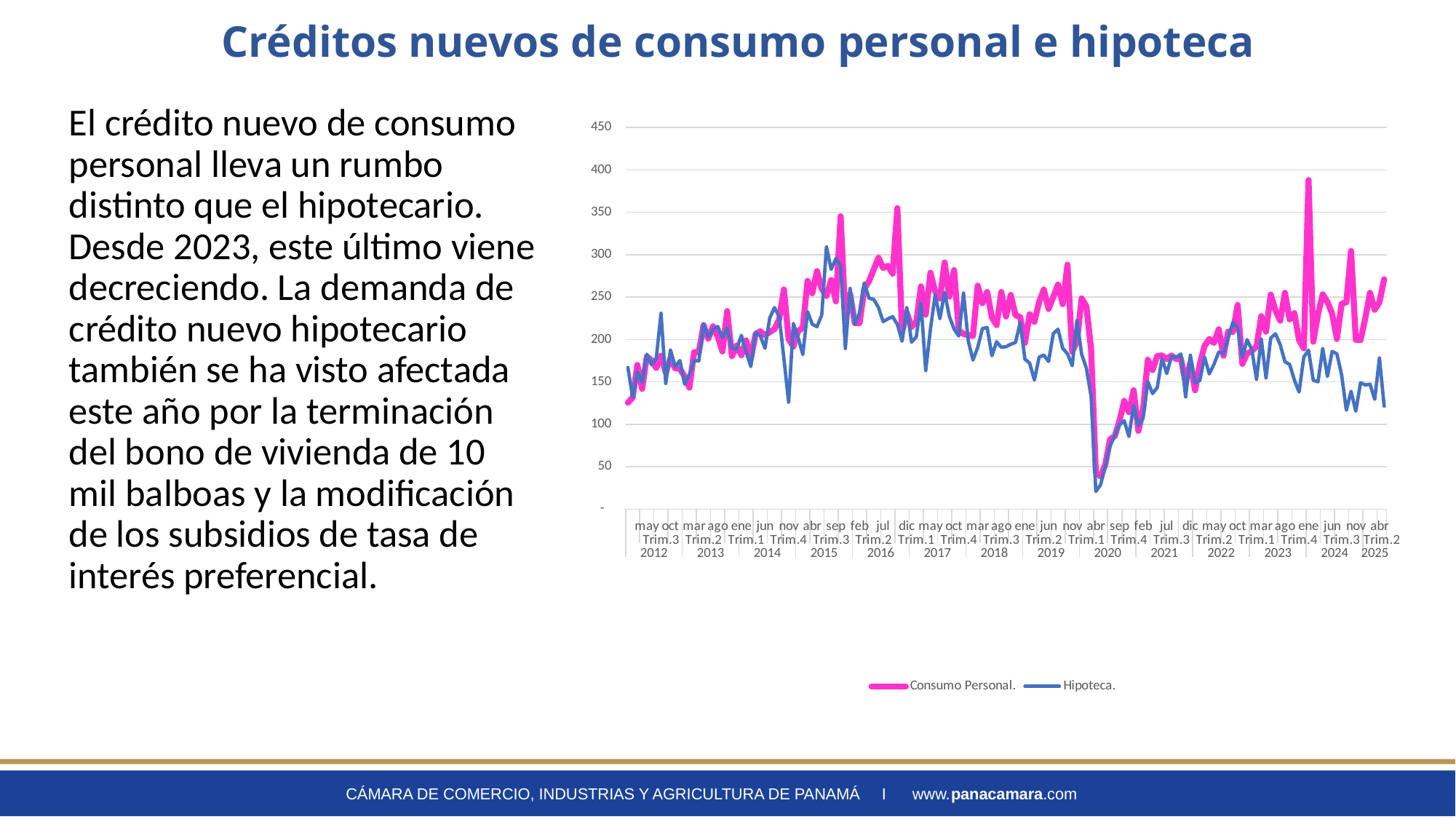
Which series is drawn in blue? Hipoteca. Is the lowest value of the Hipoteca series, reached around 2020, greater or less than 50? less How many series does the legend list? 2 At the last point on the chart (abr Trim.2 2025), which series has the higher value, Consumo Personal or Hipoteca? Consumo Personal. Is the value of the Hipoteca series at the first point on the chart (2012) greater or less than 200? less Is the value of the Consumo Personal series at the last point on the chart (2025) greater or less than 250? greater What kind of chart is shown on the slide? Line chart Which series is drawn in pink? Consumo Personal. What is the highest value shown on the vertical axis? 450 From 2023 to 2025, does the Hipoteca series generally rise or fall? fall